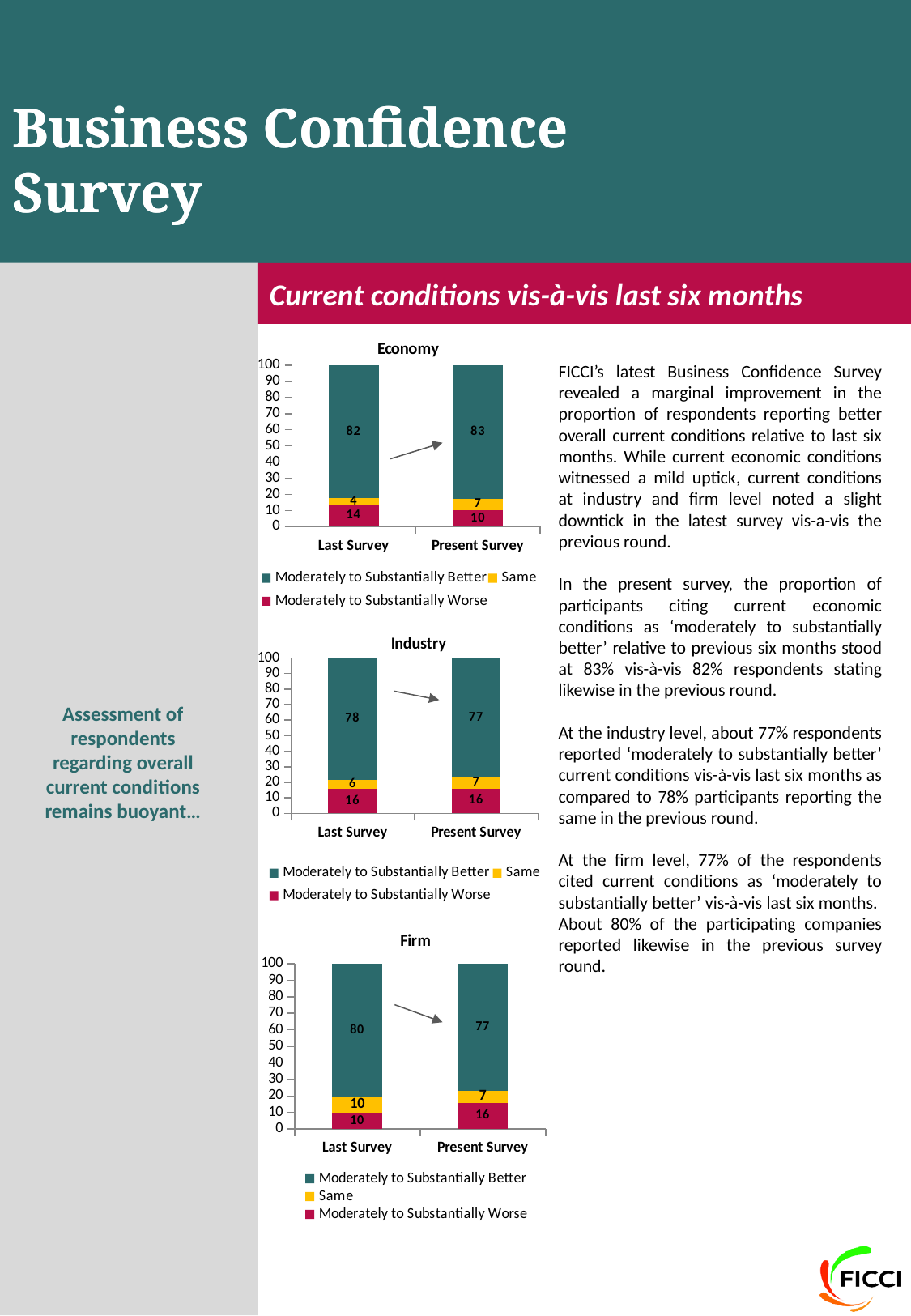
How many categories are shown on the x axis of the Industry chart? 2 In the Industry chart, what is the total of the stacked bar for the Last Survey? 100 In the Firm chart, what is the value for Moderately to Substantially Worse in the Present Survey? 16 How many series does the legend of the Firm chart list? 3 In the Industry chart, what is the value for Same in the Present Survey? 7 In the Economy chart, what is the value for Moderately to Substantially Better in the Present Survey? 83 In the Firm chart, what is the difference between the Moderately to Substantially Better values for the Last Survey and the Present Survey? 3 What kind of chart is the Economy chart? Stacked bar chart In the Firm chart, does the Moderately to Substantially Better value rise or fall from the Last Survey to the Present Survey? Fall In the Economy chart, what is the value for Moderately to Substantially Worse in the Last Survey? 14 In the Economy chart, which survey has the larger value for Moderately to Substantially Better, Last Survey or Present Survey? Present Survey What is the title of the chart at the bottom of the slide? Firm